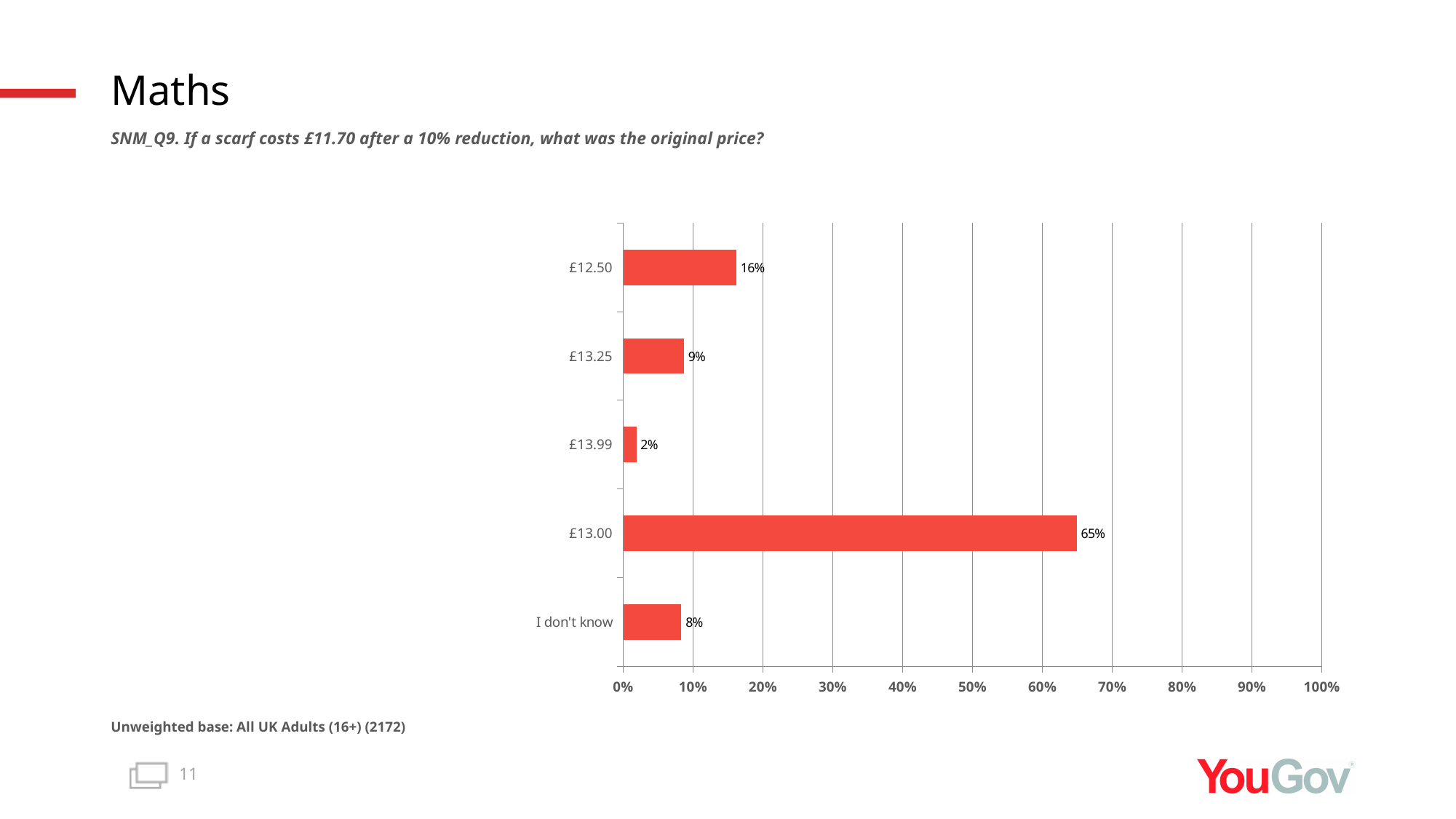
What is the difference in percentage points between £13.00 and £12.50? 49 Which answer option has the lowest percentage? £13.99 What is the difference in percentage points between £13.25 and £13.99? 7 How many answer options are shown in the chart? 5 What percentage of respondents answered £12.50? 16% Which answer option has the highest percentage? £13.00 What percentage of respondents answered 'I don't know'? 8% What is the unweighted base size stated on the slide? 2172 What percentage of respondents answered £13.00? 65% What kind of chart is shown on the slide? bar chart Which has a higher percentage, £13.25 or 'I don't know'? £13.25 Is the value for £13.00 greater or less than 60%? greater